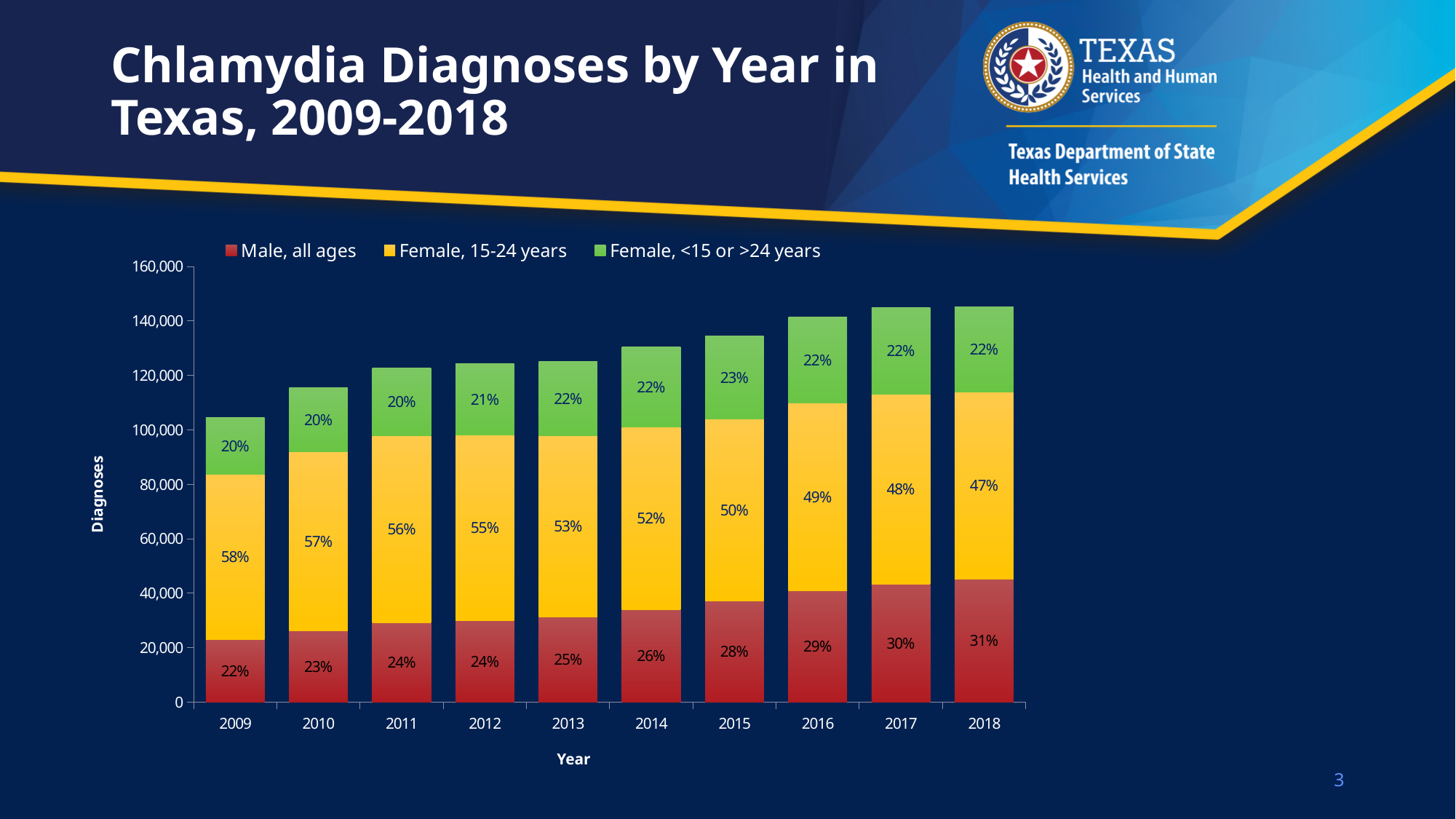
What percentage label is shown for Female, 15-24 years in 2009? 58% Which year has the lowest total number of diagnoses? 2009 Is the total number of diagnoses in 2018 greater or less than 140,000? greater Does the percentage for Female, 15-24 years rise or fall from 2009 to 2018? Falls How many series does the legend list? 3 Does the percentage for Male, all ages rise or fall from 2009 to 2018? Rises How many years are shown on the x axis? 10 By how many percentage points does the Female, 15-24 years share in 2009 exceed that in 2018? 11 percentage points Is the total number of diagnoses in 2009 greater or less than 120,000? less What percentage label is shown for Male, all ages in 2018? 31% What percentage label is shown for Female, <15 or >24 years in 2015? 23% What kind of chart is shown on the slide? Stacked bar chart